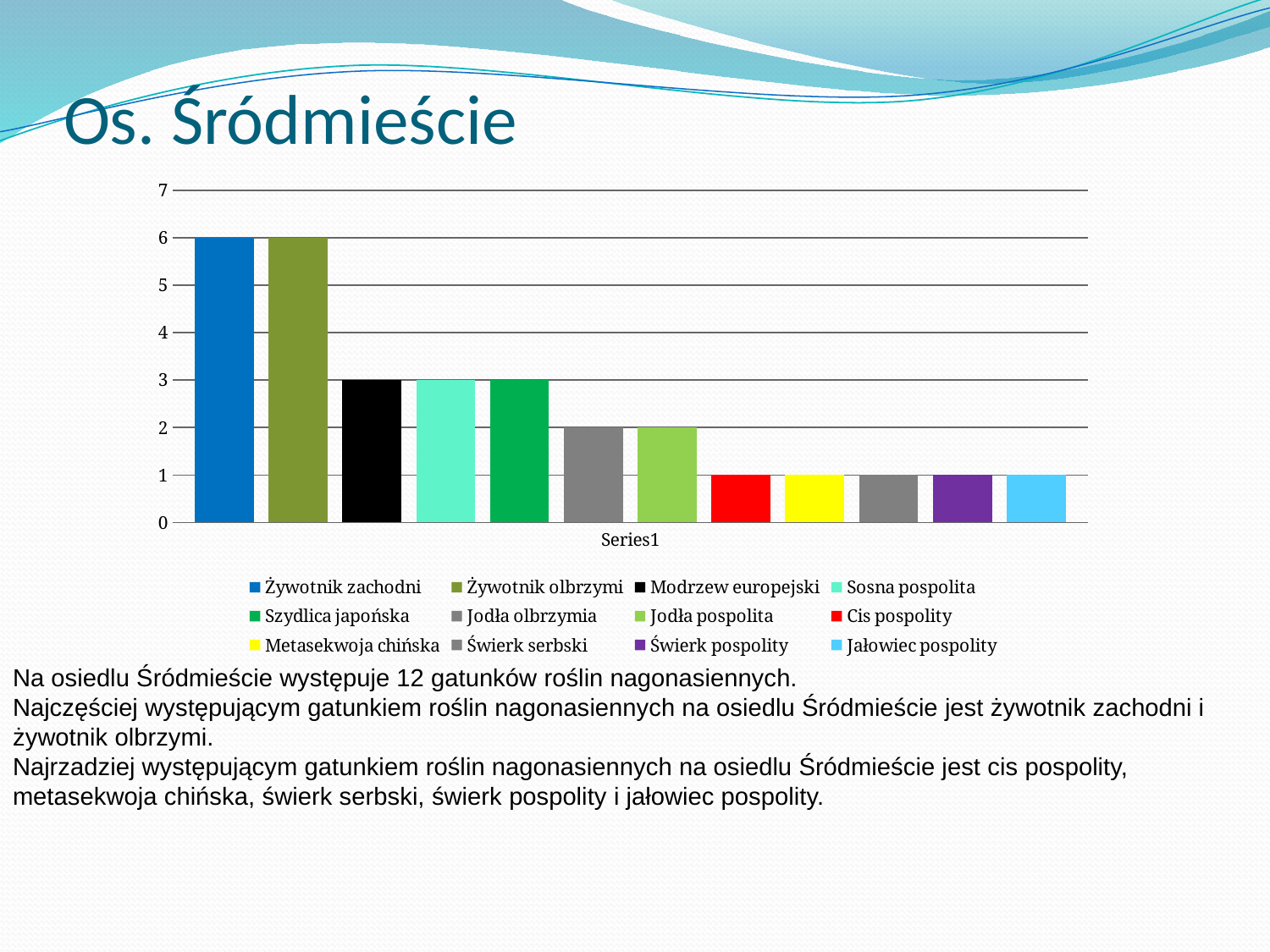
What is the value for Jałowiec pospolity? 1 What is the difference between the values for Jodła pospolita and Świerk serbski? 1 What is the value for Modrzew europejski? 3 How many series does the legend list? 12 What is the value for Żywotnik zachodni? 6 What is the value for Cis pospolity? 1 What is the difference between the values for Żywotnik olbrzymi and Sosna pospolita? 3 Is the value for Żywotnik olbrzymi greater or less than 5? greater What kind of chart is shown on the slide? bar chart What is the value for Jodła olbrzymia? 2 Which is larger, the value for Szydlica japońska or the value for Jodła pospolita? Szydlica japońska What is the label shown on the x axis below the bars? Series1